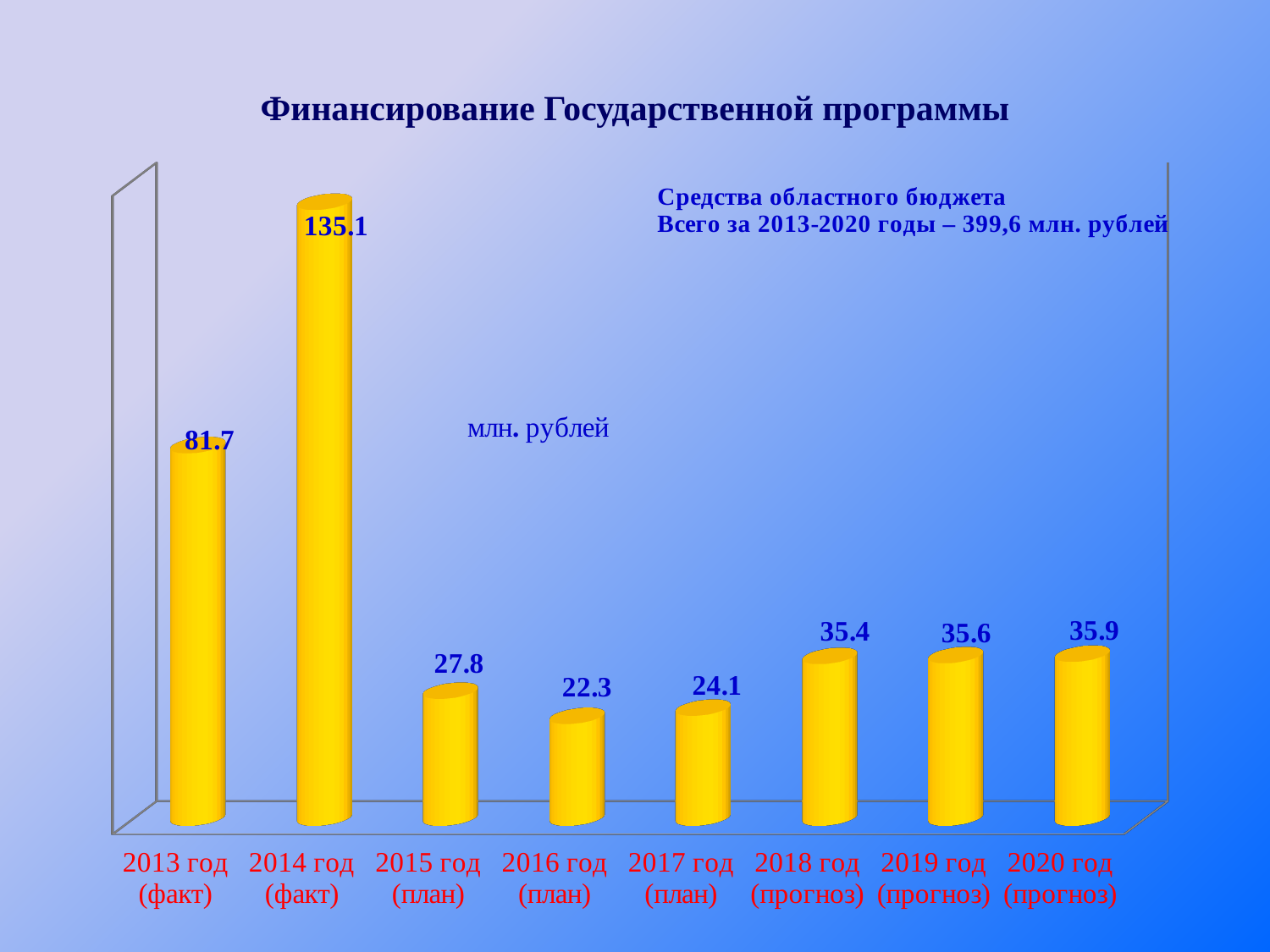
What kind of chart is shown on the slide? bar chart What is the difference between the values for 2014 год (факт) and 2013 год (факт)? 53.4 Which is larger, the value for 2015 год (план) or the value for 2017 год (план)? 2015 год (план) Which year has the highest value? 2014 год (факт) What is the difference between the values for 2018 год (прогноз) and 2017 год (план)? 11.3 What is the title of the chart? Финансирование Государственной программы Which year has the lowest value? 2016 год (план) What is the value for 2014 год (факт)? 135.1 How many years are shown on the chart? 8 What is the value for 2016 год (план)? 22.3 What is the value for 2020 год (прогноз)? 35.9 Do the values rise or fall from 2018 год to 2020 год? rise